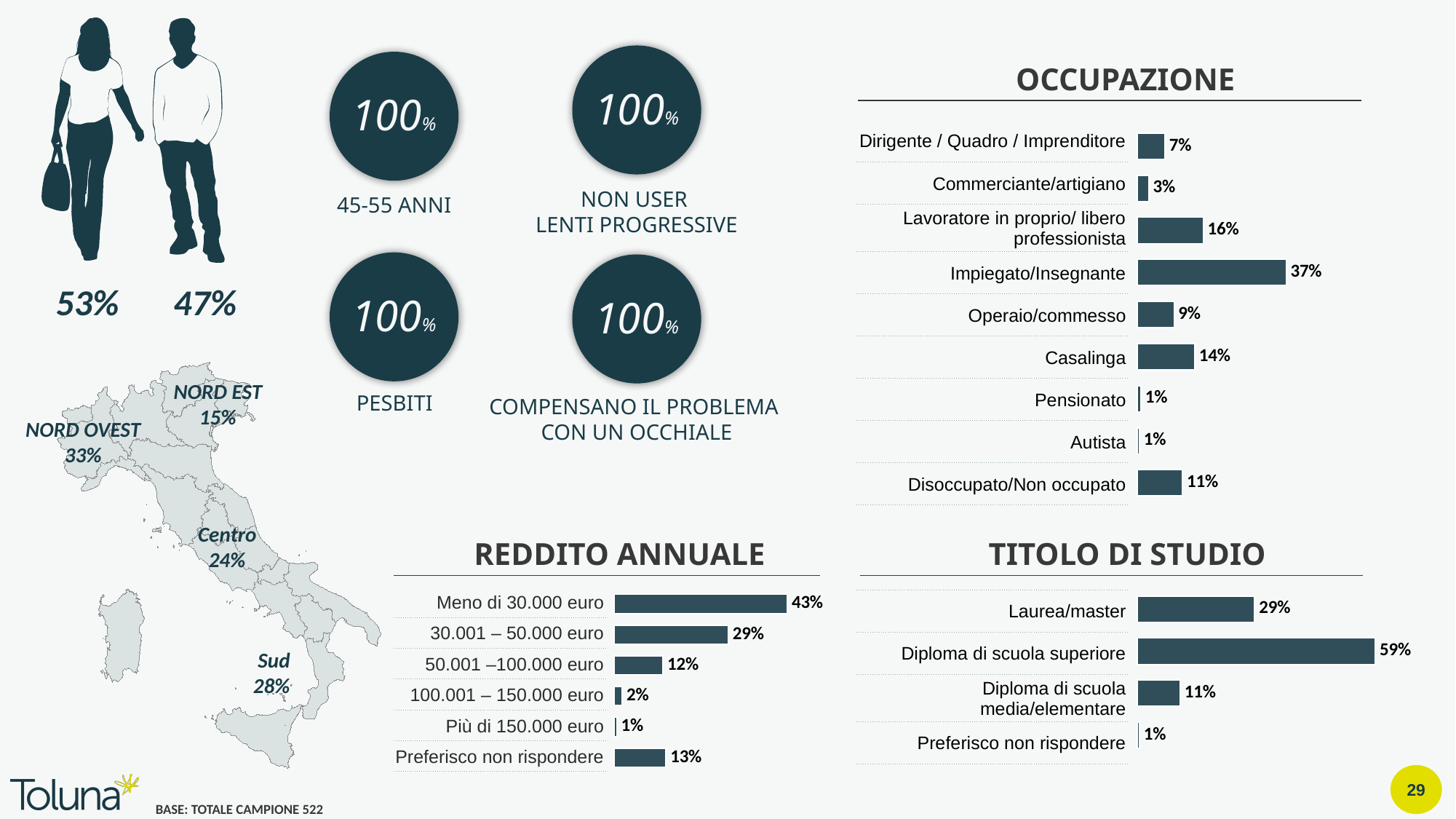
In the OCCUPAZIONE chart, which category has the highest value? Impiegato/Insegnante What kind of chart is the TITOLO DI STUDIO chart? Bar chart In the REDDITO ANNUALE chart, how many categories are shown? 6 In the OCCUPAZIONE chart, what is the value for Casalinga? 14% In the TITOLO DI STUDIO chart, what is the value for Diploma di scuola superiore? 59% In the REDDITO ANNUALE chart, which is larger: 50.001 –100.000 euro or Preferisco non rispondere? Preferisco non rispondere In the OCCUPAZIONE chart, what is the value for Impiegato/Insegnante? 37% In the REDDITO ANNUALE chart, what is the value for Meno di 30.000 euro? 43% In the OCCUPAZIONE chart, how many categories are shown? 9 In the TITOLO DI STUDIO chart, what is the difference between Diploma di scuola superiore and Laurea/master? 30% In the OCCUPAZIONE chart, what is the difference between Impiegato/Insegnante and Lavoratore in proprio/ libero professionista? 21% In the REDDITO ANNUALE chart, which category has the lowest value? Più di 150.000 euro